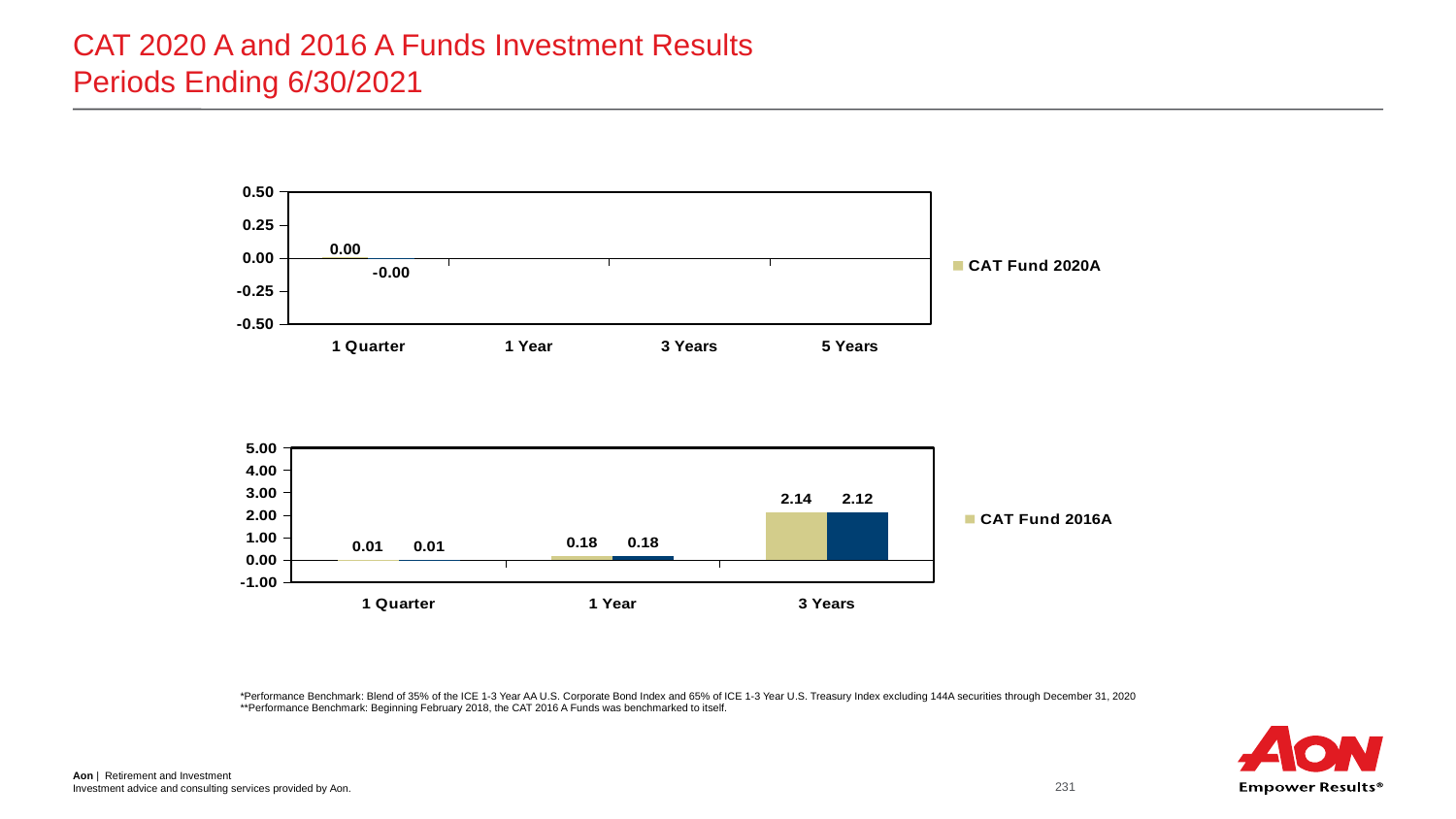
What type of chart is the bottom chart (CAT Fund 2016A)? bar chart In the bottom chart (CAT Fund 2016A), which period has the lowest value for the tan bars? 1 Quarter In the bottom chart (CAT Fund 2016A), what is the value of the tan bar for 1 Year? 0.18 In the bottom chart (CAT Fund 2016A), what is the value of the tan bar for 3 Years? 2.14 In the bottom chart (CAT Fund 2016A), what is the value of the tan bar for 1 Quarter? 0.01 In the bottom chart (CAT Fund 2016A), do the tan bar values rise or fall from 1 Quarter to 3 Years? rise In the top chart (CAT Fund 2020A), what value is labelled above the axis for 1 Quarter? 0.00 In the bottom chart (CAT Fund 2016A), what is the value of the dark blue bar for 3 Years? 2.12 How many period categories are shown on the x axis of the bottom chart (CAT Fund 2016A)? 3 How many period categories are shown on the x axis of the top chart (CAT Fund 2020A)? 4 In the bottom chart (CAT Fund 2016A), which period has the highest value for the tan bars? 3 Years In the bottom chart (CAT Fund 2016A), what is the difference between the tan bar and the dark blue bar for 3 Years? 0.02